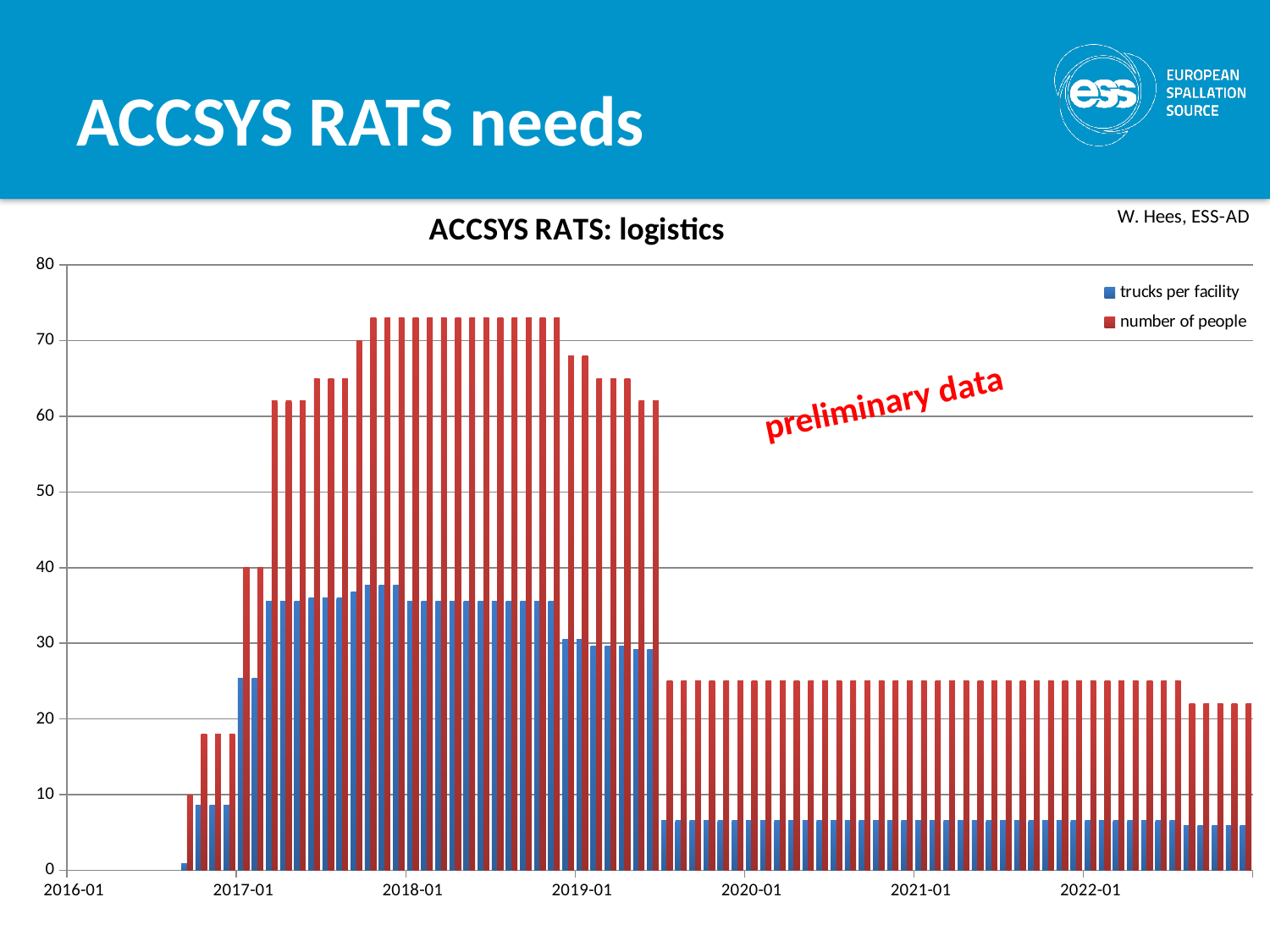
Is the value for trucks per facility at 2021-01 greater or less than 10? less Is the value for number of people at 2020-01 greater or less than 20? greater Does the number of people rise or fall between 2017-01 and 2018-01? rise At 2018-01, which series has the larger value, trucks per facility or number of people? number of people Is the value for number of people at 2018-01 greater or less than 70? greater What annotation is written in red across the chart? preliminary data How many series does the legend list? 2 What kind of chart is shown on the slide? bar chart Does the number of people rise or fall between 2019-01 and 2020-01? fall What are the two series named in the legend? trucks per facility; number of people